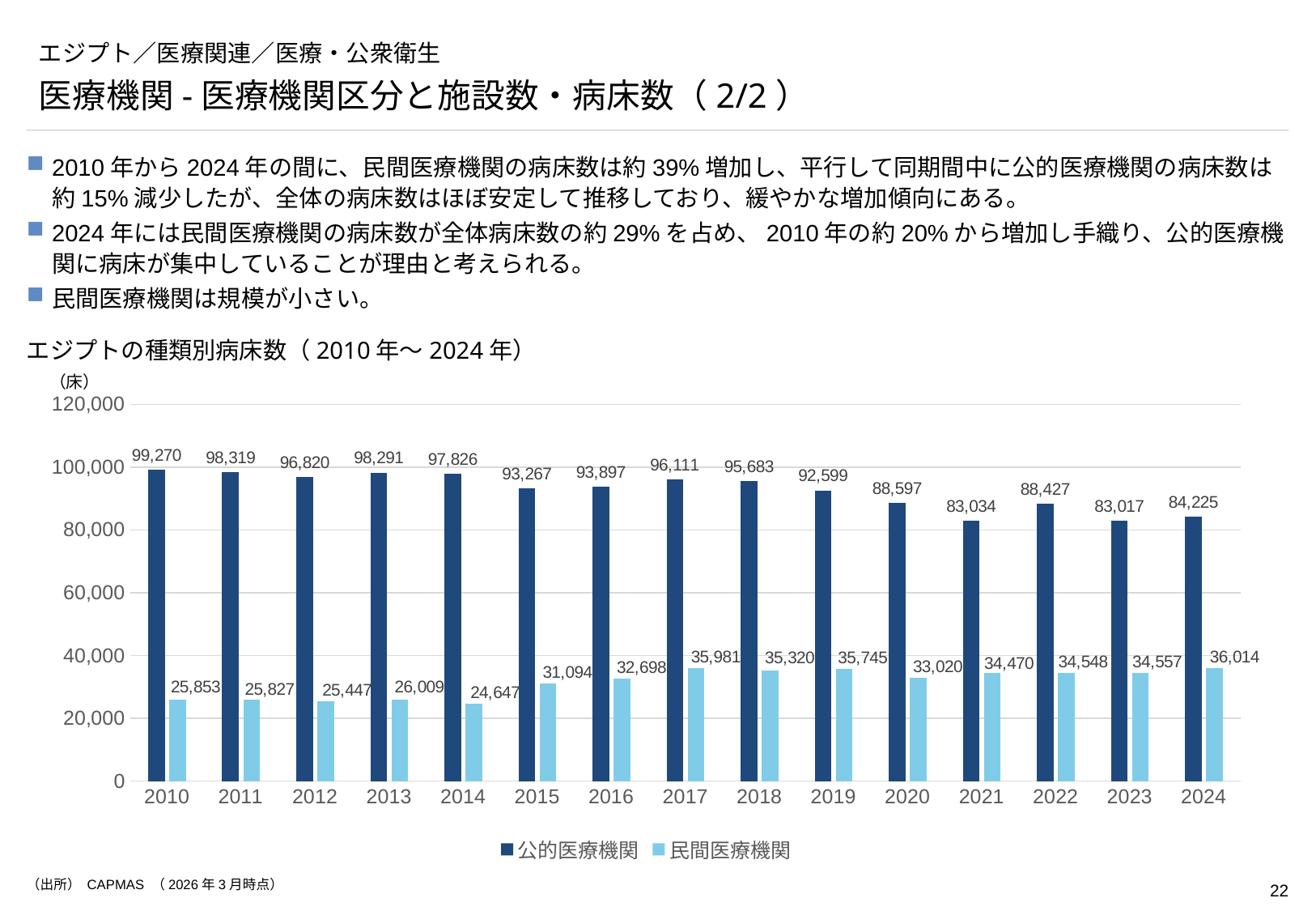
In which year is the value for 民間医療機関 lowest? 2014 How many years are shown on the x axis? 15 How many series does the legend list? 2 Which is larger in 2022: 公的医療機関 or 民間医療機関? 公的医療機関 By how much did the value for 公的医療機関 fall from 2010 to 2024? 15,045 What is the difference between 公的医療機関 and 民間医療機関 in 2010? 73,417 What is the value for 公的医療機関 in 2010? 99,270 What is the value for 民間医療機関 in 2024? 36,014 What kind of chart is shown on the slide? bar chart In which year is the value for 公的医療機関 highest? 2010 What is the value for 民間医療機関 in 2015? 31,094 Is the value for 公的医療機関 in 2024 greater or less than 80,000? greater